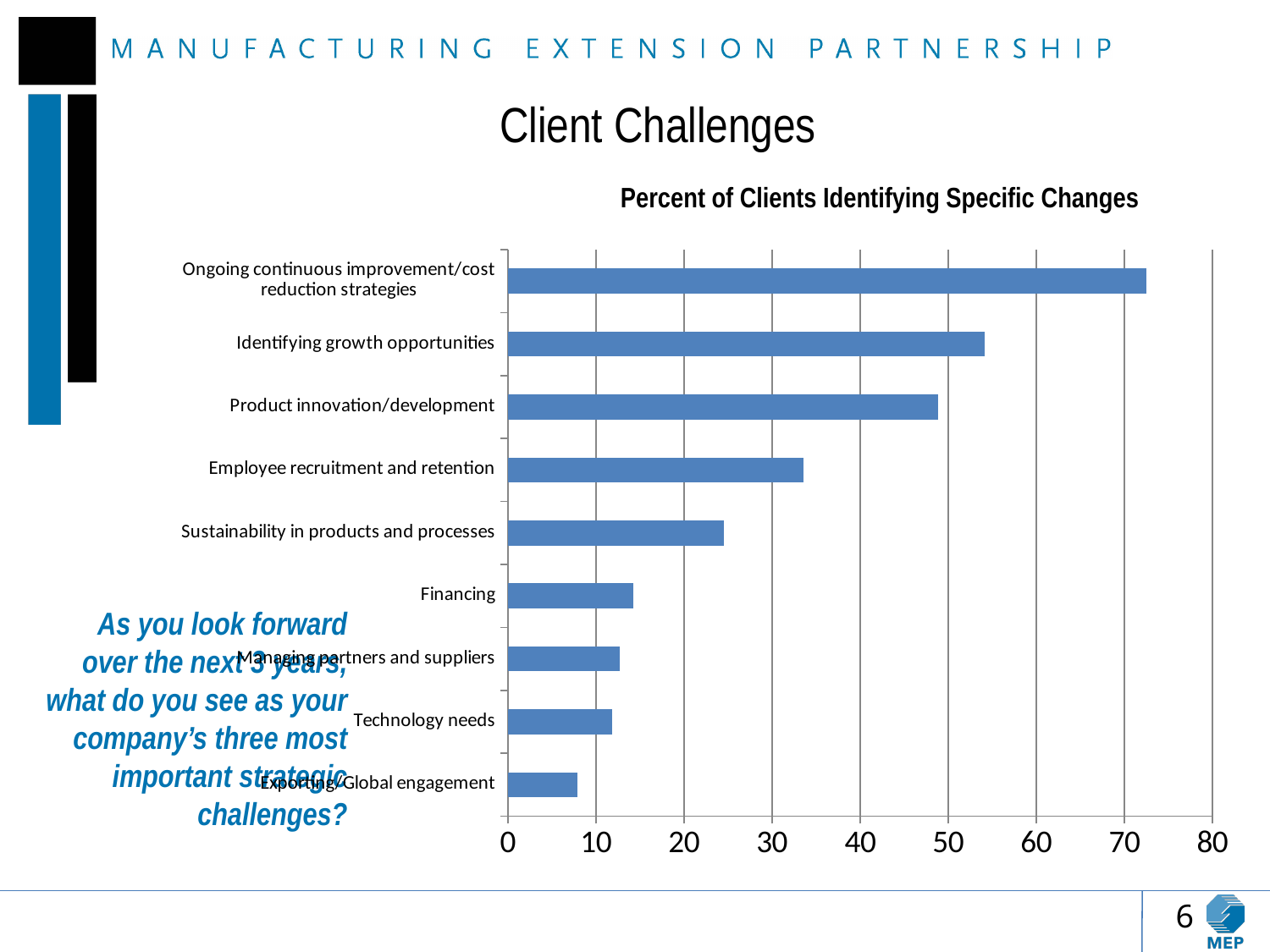
Is the value for Identifying growth opportunities greater or less than 50? greater Is the value for Sustainability in products and processes greater or less than 30? less Which is larger, the value for Financing or the value for Exporting/Global engagement? Financing Which category has the lowest value? Exporting/Global engagement Is the value for Exporting/Global engagement greater or less than 10? less Which category has the highest value? Ongoing continuous improvement/cost reduction strategies How many categories are plotted in the chart? 9 Which is larger, the value for Employee recruitment and retention or the value for Sustainability in products and processes? Employee recruitment and retention What kind of chart is shown on the slide? Bar chart What is the title of the chart? Percent of Clients Identifying Specific Changes